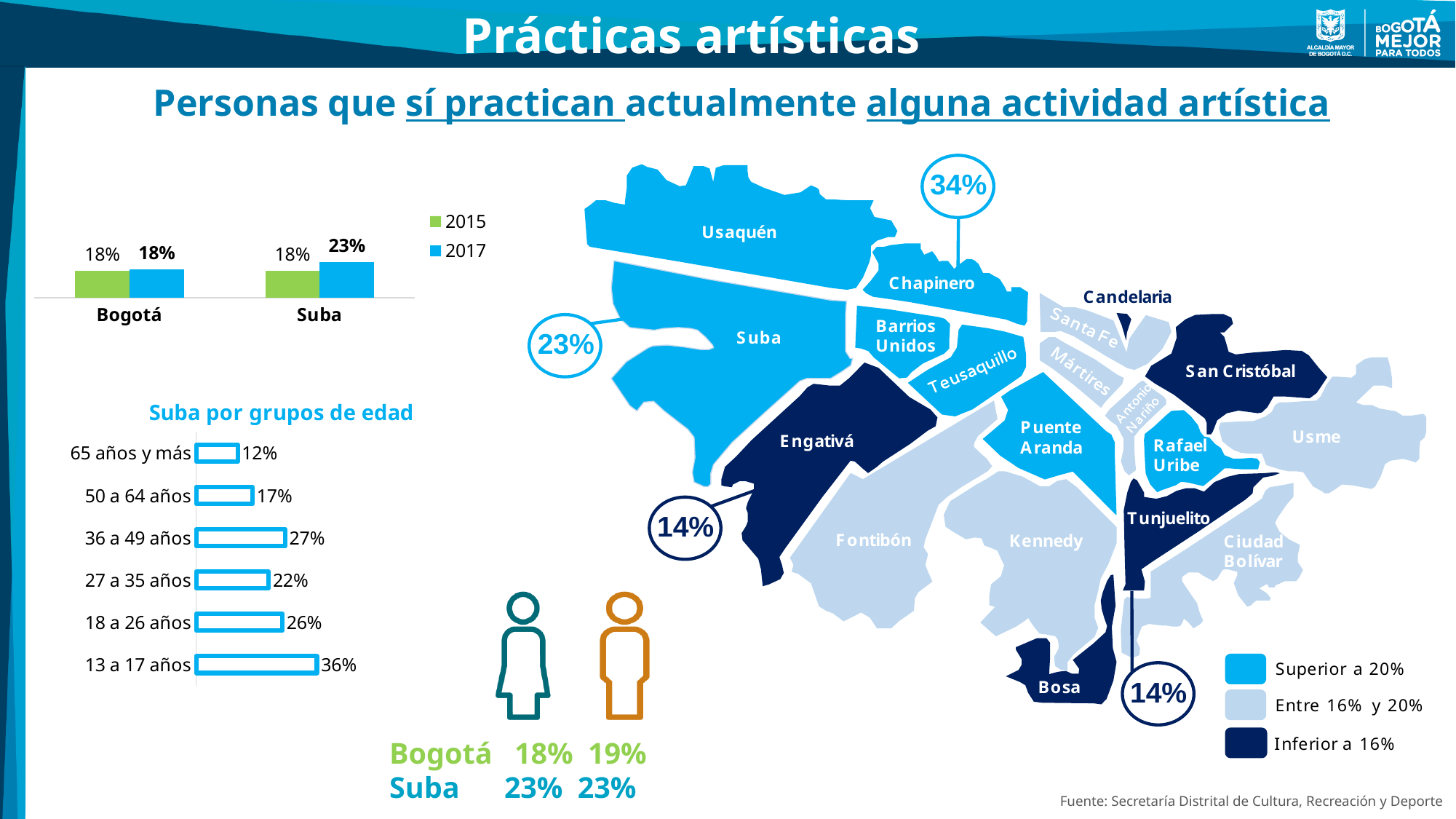
In the top-left bar chart, what is the value for Bogotá in 2015? 18% In the top-left bar chart, what is the value for Suba in 2017? 23% In the top-left bar chart, how many series does the legend list? 2 In the top-left bar chart, what is the difference between Suba's 2017 value and its 2015 value? 5% In the top-left bar chart, which colour represents 2015? Green In the top-left bar chart, which is larger for 2017: Bogotá or Suba? Suba In the chart 'Suba por grupos de edad', what is the value for 36 a 49 años? 27% What kind of chart is 'Suba por grupos de edad'? Bar chart In the chart 'Suba por grupos de edad', which age group has the highest value? 13 a 17 años In the chart 'Suba por grupos de edad', what is the difference between the values for 13 a 17 años and 65 años y más? 24% In the chart 'Suba por grupos de edad', how many age groups are shown? 6 In the chart 'Suba por grupos de edad', which age group has the lowest value? 65 años y más